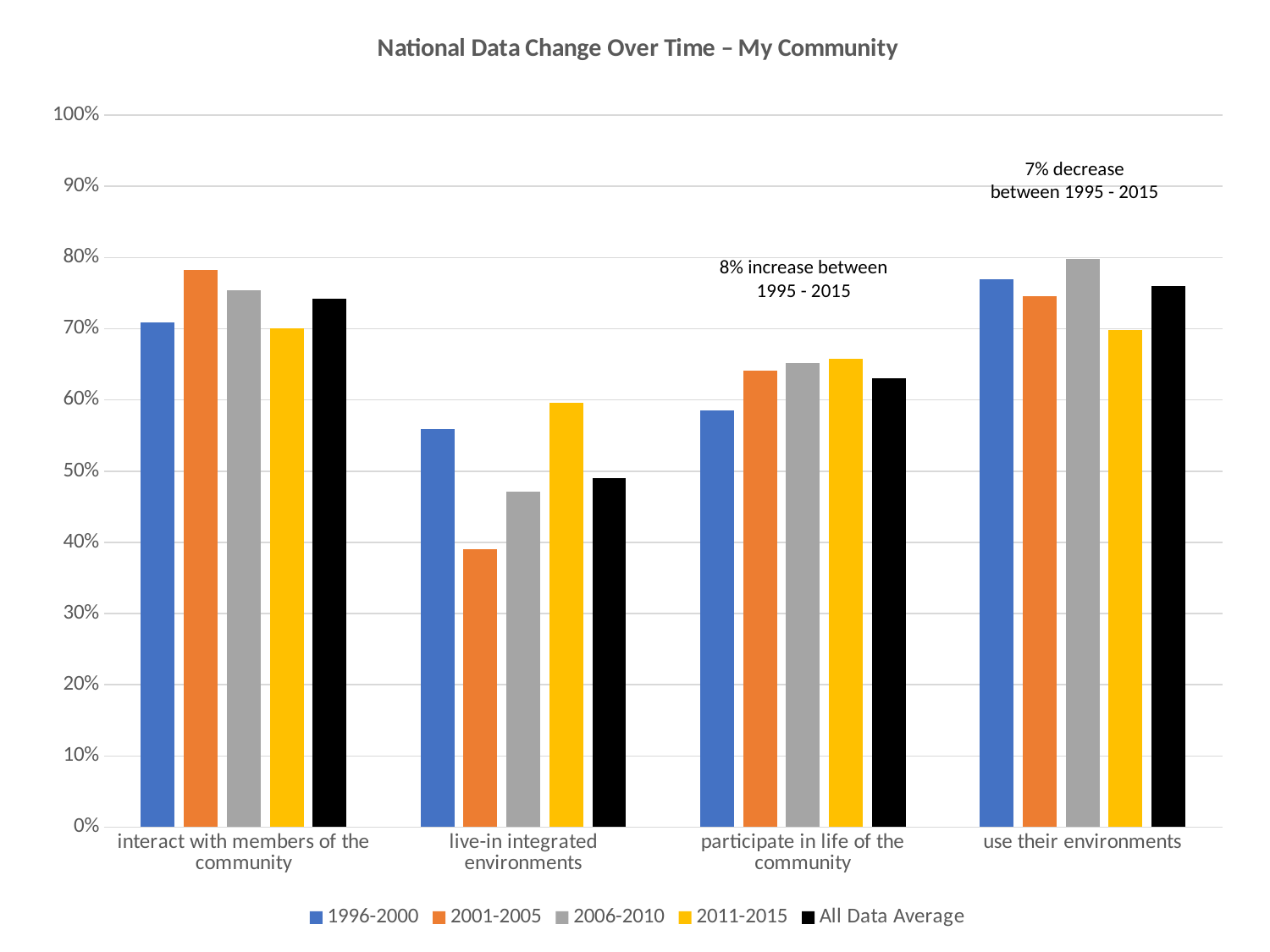
Which series has the highest value in the 'live-in integrated environments' category? 2011-2015 How many categories are shown on the x axis? 4 Above which category does the annotation '8% increase between 1995 - 2015' appear? participate in life of the community What kind of chart is shown on the slide? bar chart What is the title of the chart? National Data Change Over Time – My Community In the 'interact with members of the community' category, which is larger: the 2001-2005 value or the 2011-2015 value? 2001-2005 Which category has the lowest value for the 2001-2005 series? live-in integrated environments Is the value for 1996-2000 in the 'participate in life of the community' category greater or less than 60%? less Which series has the highest value in the 'use their environments' category? 2006-2010 Is the value for 2001-2005 in the 'live-in integrated environments' category greater or less than 50%? less Is the value for 2006-2010 in the 'use their environments' category greater or less than 70%? greater How many series does the legend list? 5